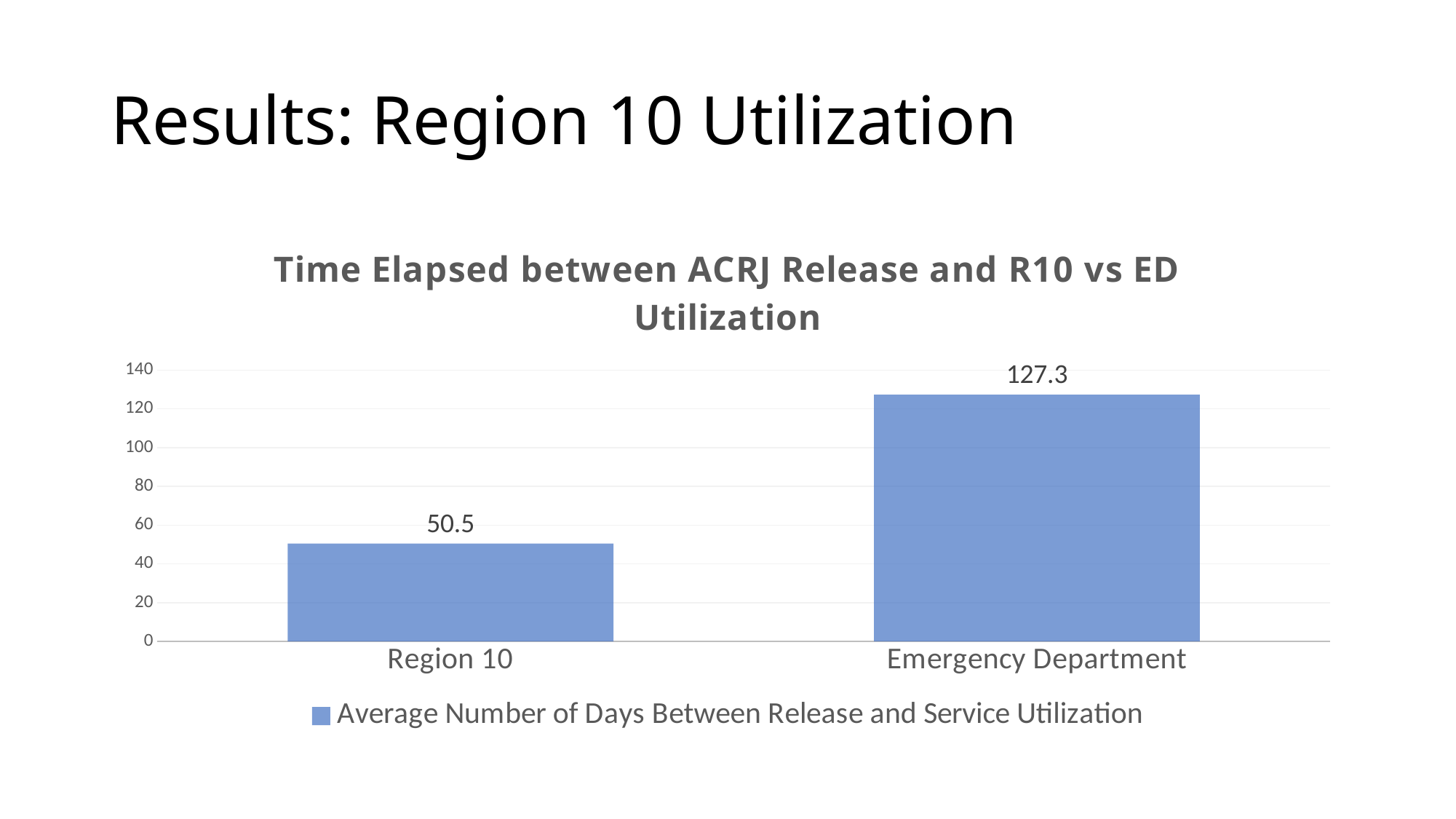
What kind of chart is shown? bar chart Is the value for Region 10 greater or less than 60? less What is the value for Emergency Department? 127.3 Is the value for Emergency Department greater or less than 100? greater How many categories are shown on the x axis? 2 How many series does the legend list? 1 What is the difference between the Emergency Department value and the Region 10 value? 76.8 Which category has the highest value? Emergency Department Which category has the lowest value? Region 10 What is the title of the chart? Time Elapsed between ACRJ Release and R10 vs ED Utilization What is the value for Region 10? 50.5 Which is larger, the value for Region 10 or the value for Emergency Department? Emergency Department